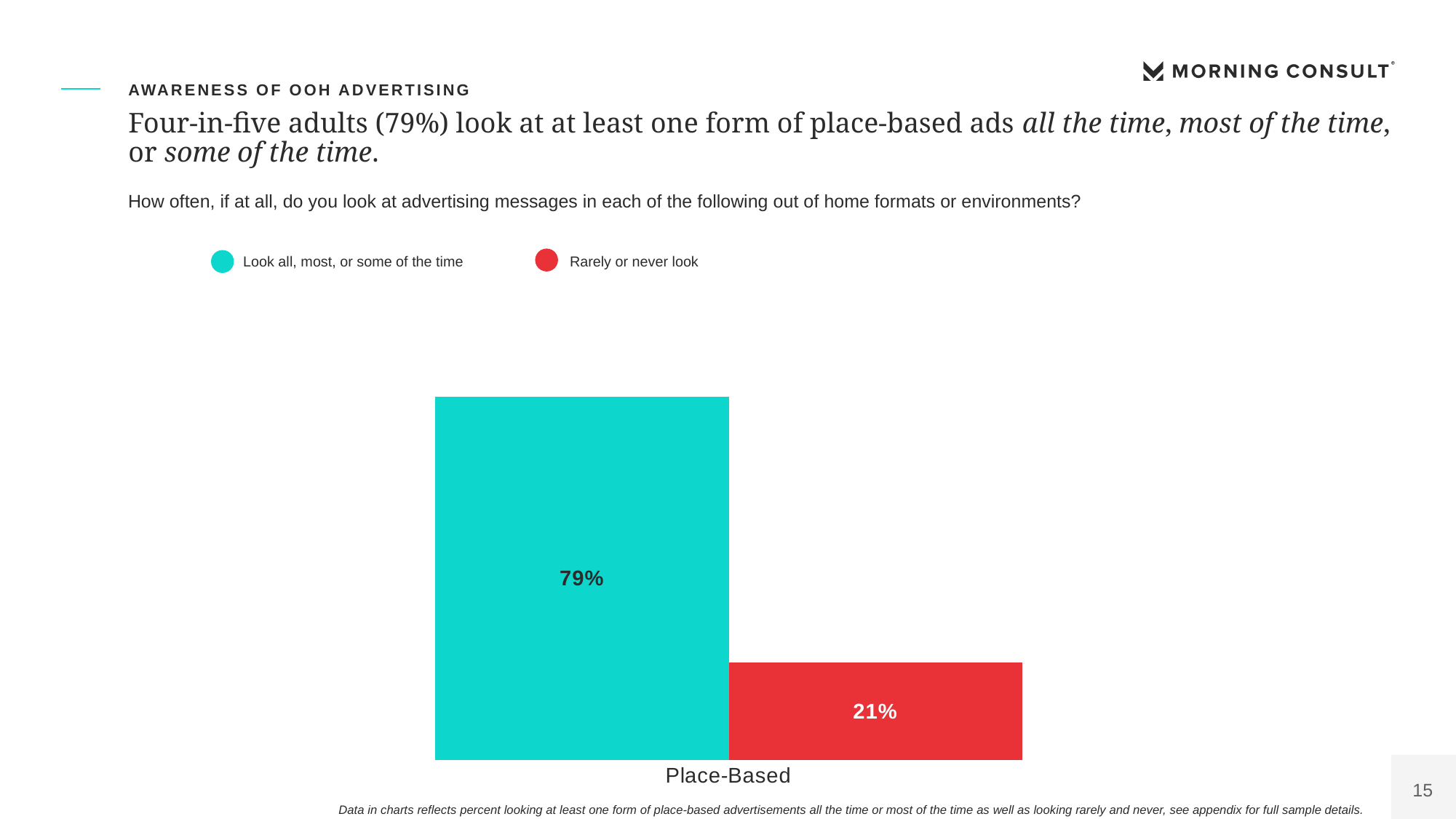
How many categories are shown on the x axis? 1 What is the category label shown under the bars? Place-Based What colour is the bar for 'Rarely or never look'? red What is the total of the two values shown for Place-Based? 100% How many series does the legend list? 2 Which series has the lower value for Place-Based? Rarely or never look What percentage of adults rarely or never look at place-based ads? 21% What percentage of adults look at place-based ads all, most, or some of the time? 79% What is the difference between the 'Look all, most, or some of the time' value and the 'Rarely or never look' value? 58% Is the value for 'Rarely or never look' larger or smaller than the value for 'Look all, most, or some of the time'? smaller Which series has the higher value for Place-Based? Look all, most, or some of the time What kind of chart is shown on the slide? bar chart